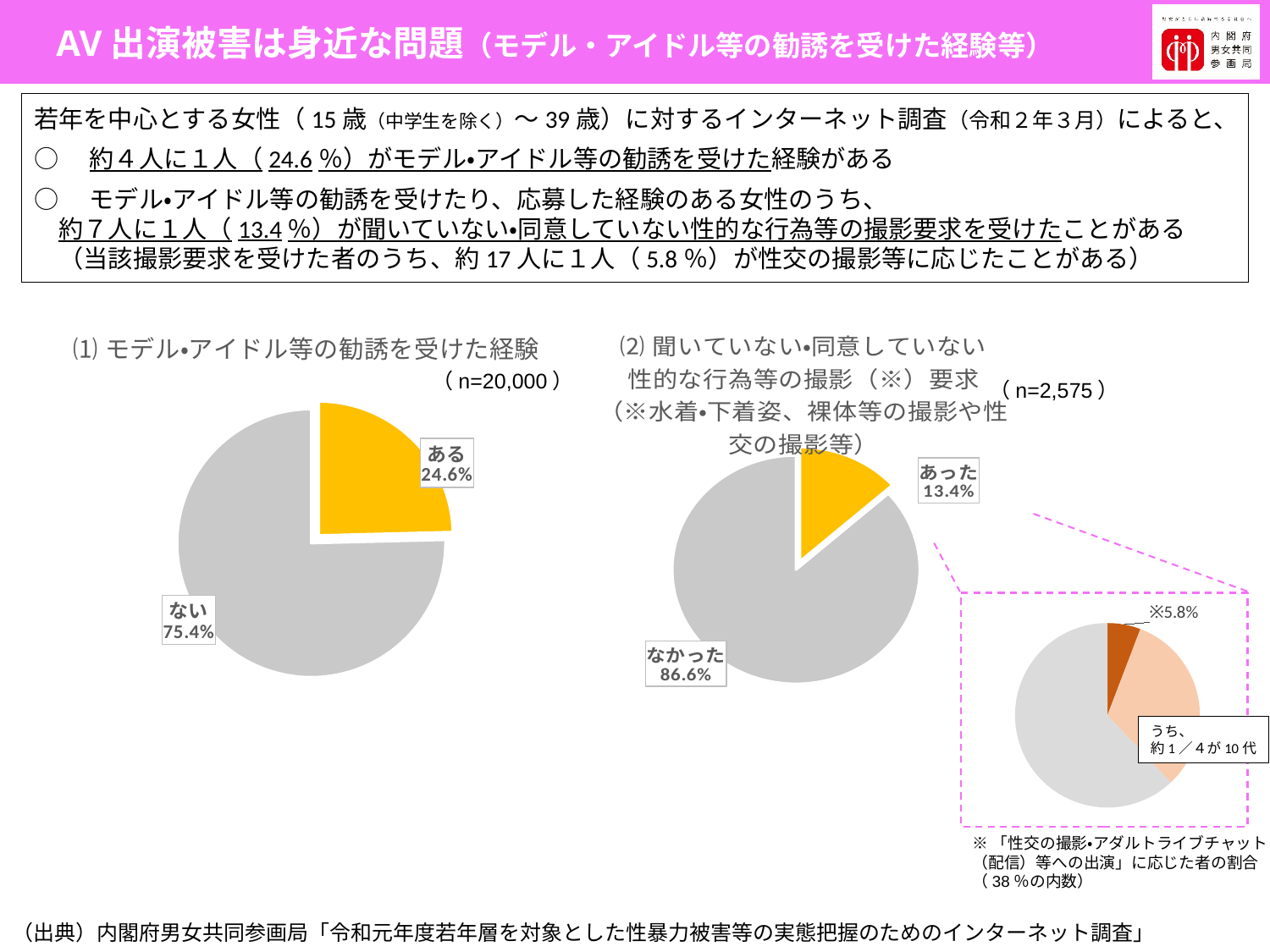
In the right pie chart (2) 聞いていない・同意していない性的な行為等の撮影要求, what percentage is labelled なかった? 86.6% In the left pie chart (1), what is the difference in percentage points between ない and ある? 50.8 How many slices does the right pie chart (2) have? 2 In the left pie chart (1) モデル・アイドル等の勧誘を受けた経験, what percentage is labelled ある? 24.6% In the left pie chart (1) モデル・アイドル等の勧誘を受けた経験, what percentage is labelled ない? 75.4% What kind of chart is used for (1) モデル・アイドル等の勧誘を受けた経験? Pie chart What is the sample size (n) shown for the left pie chart (1)? n=20,000 In the small inset pie chart at the bottom right, what percentage is shown for the dark orange slice marked ※? 5.8% In the right pie chart (2), which slice is the smallest? あった What is the sample size (n) shown for the right pie chart (2)? n=2,575 In the left pie chart (1), which slice is larger, ある or ない? ない In the right pie chart (2) 聞いていない・同意していない性的な行為等の撮影要求, what percentage is labelled あった? 13.4%